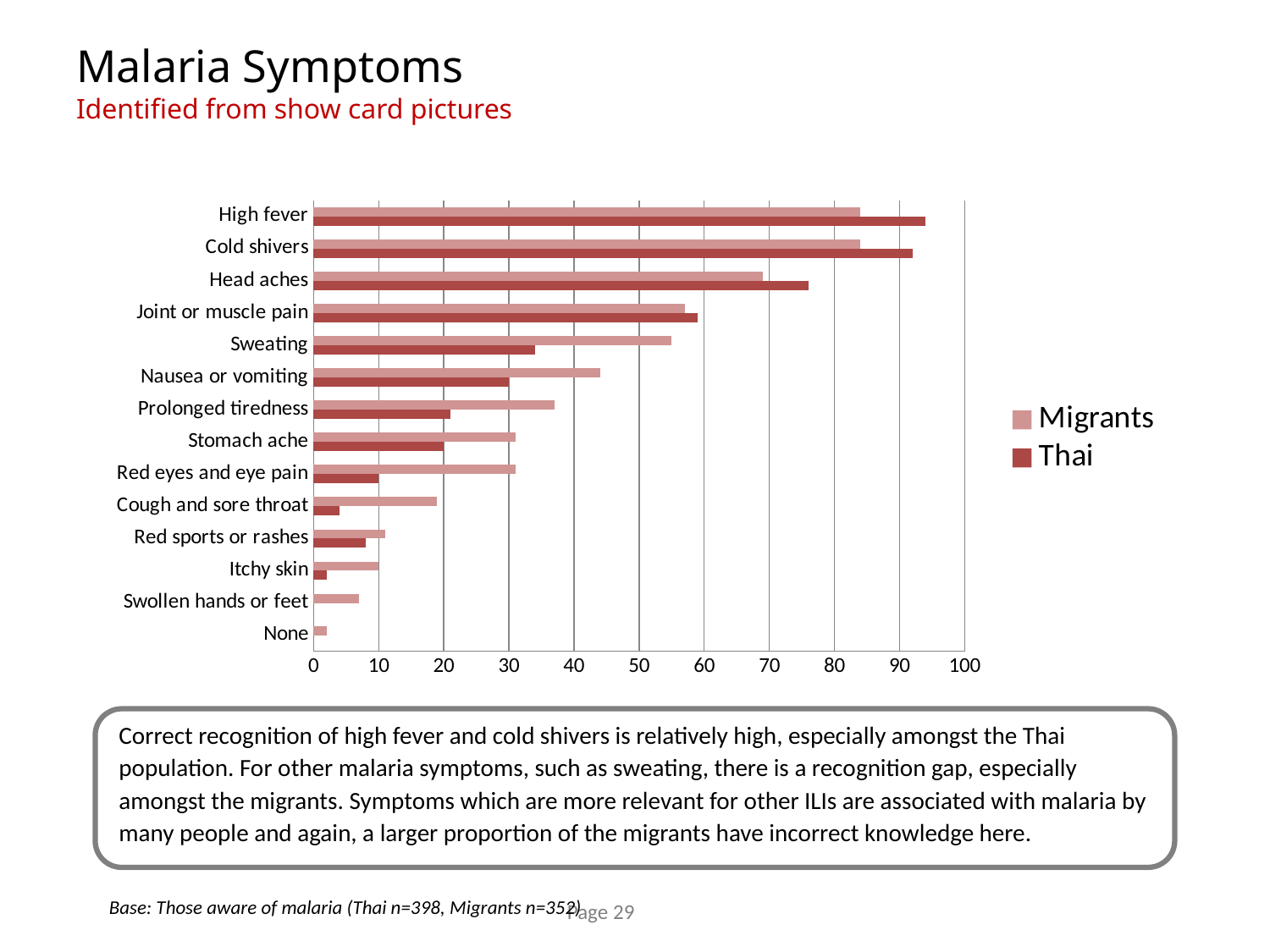
Is the Thai value for High fever greater or less than 90? greater Is the Migrants value for Sweating greater or less than 50? greater Which symptom has the lowest Migrants value? None Is the Migrants value for Head aches greater or less than 60? greater What kind of chart is shown on the slide? Bar chart How many symptom categories are plotted on the chart? 14 How many series does the legend list? 2 For Sweating, which group has the larger value, Migrants or Thai? Migrants Which series is shown in the darker red colour in the legend? Thai For High fever, which group has the larger value, Migrants or Thai? Thai